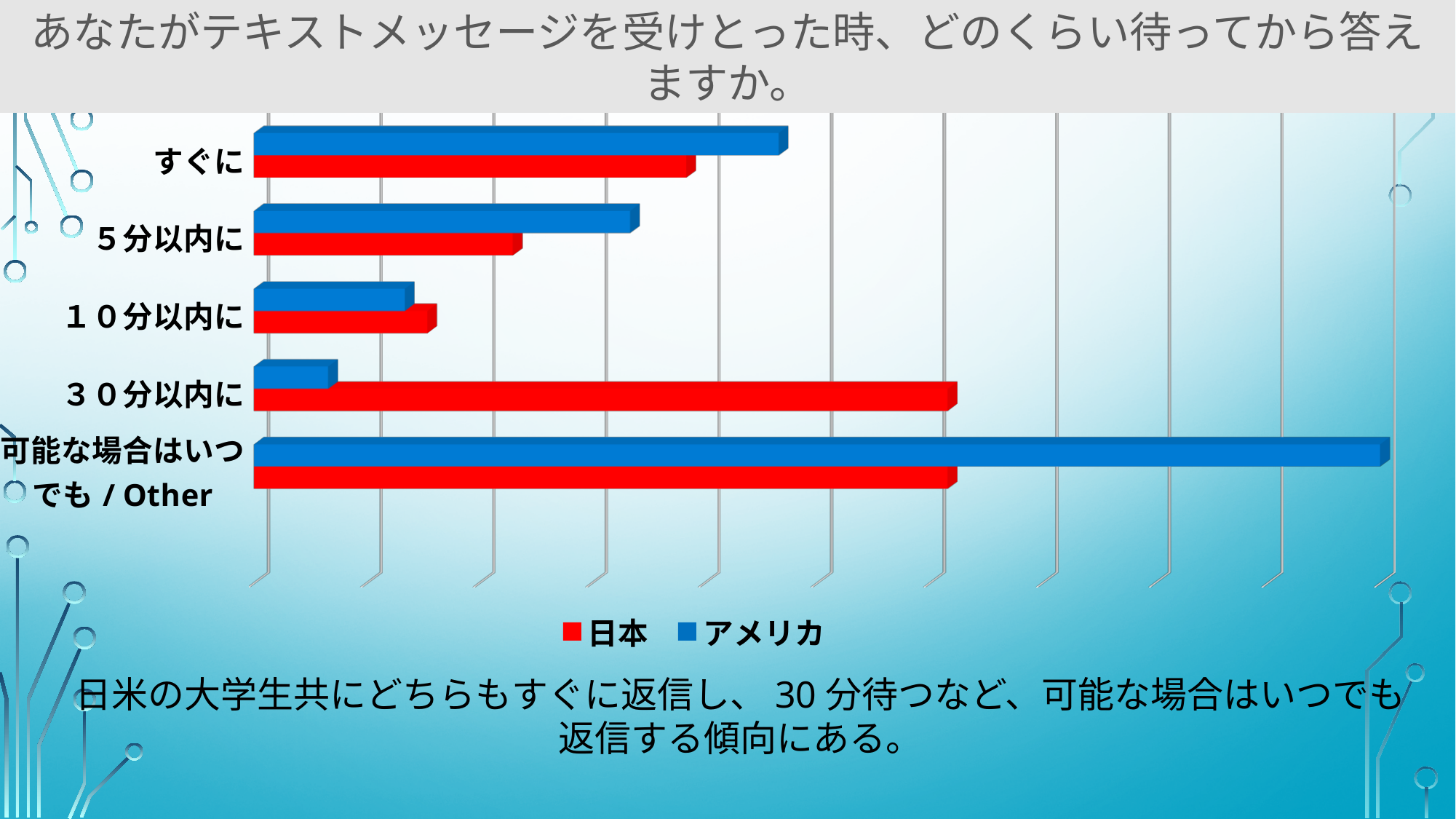
What kind of chart is shown on the slide? bar chart For すぐに, which series has the larger value, 日本 or アメリカ? アメリカ How many series does the legend list? 2 For ３０分以内に, which series has the larger value, 日本 or アメリカ? 日本 Which category has the highest value for アメリカ? 可能な場合はいつでも / Other For 可能な場合はいつでも / Other, which series has the larger value, 日本 or アメリカ? アメリカ Which colour represents 日本 in the chart? red Which category has the lowest value for 日本? １０分以内に Which colour represents アメリカ in the chart? blue How many categories are shown on the chart? 5 Which category has the lowest value for アメリカ? ３０分以内に